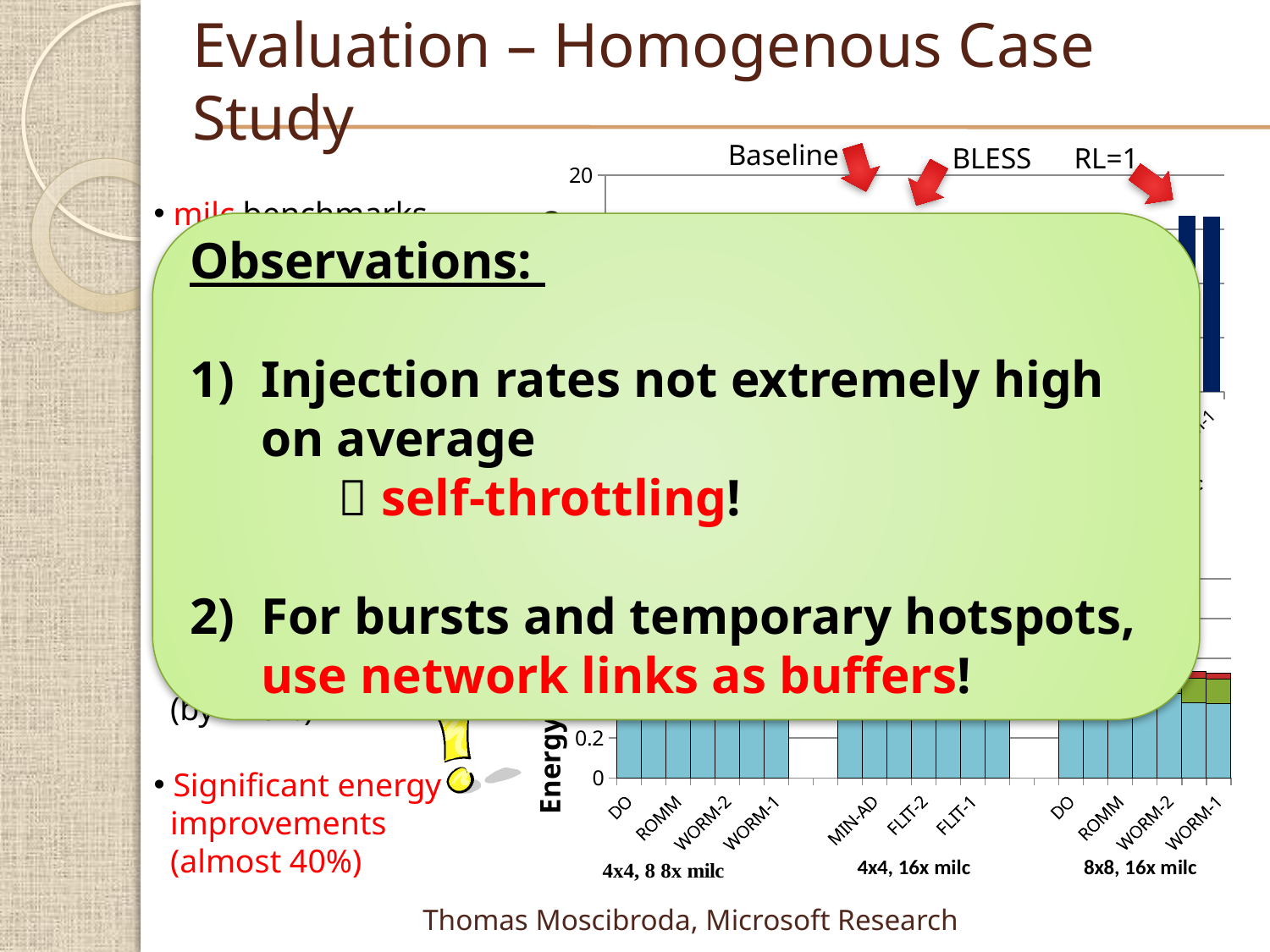
What is the y-axis label of the bottom chart? Energy In the bottom Energy chart, is the value for DO in the 4x4, 8 8x milc group greater or less than 0.2? greater What is the label of the rightmost group in the bottom Energy chart? 8x8, 16x milc How many categories are labelled along the x axis of the bottom Energy chart? 11 What kind of chart is the bottom chart labelled Energy? bar chart How many configuration groups are labelled below the x axis of the bottom Energy chart? 3 How many series are labelled above the top chart? 3 In the bottom Energy chart, is the value for WORM-1 in the 8x8, 16x milc group greater or less than 0.2? greater